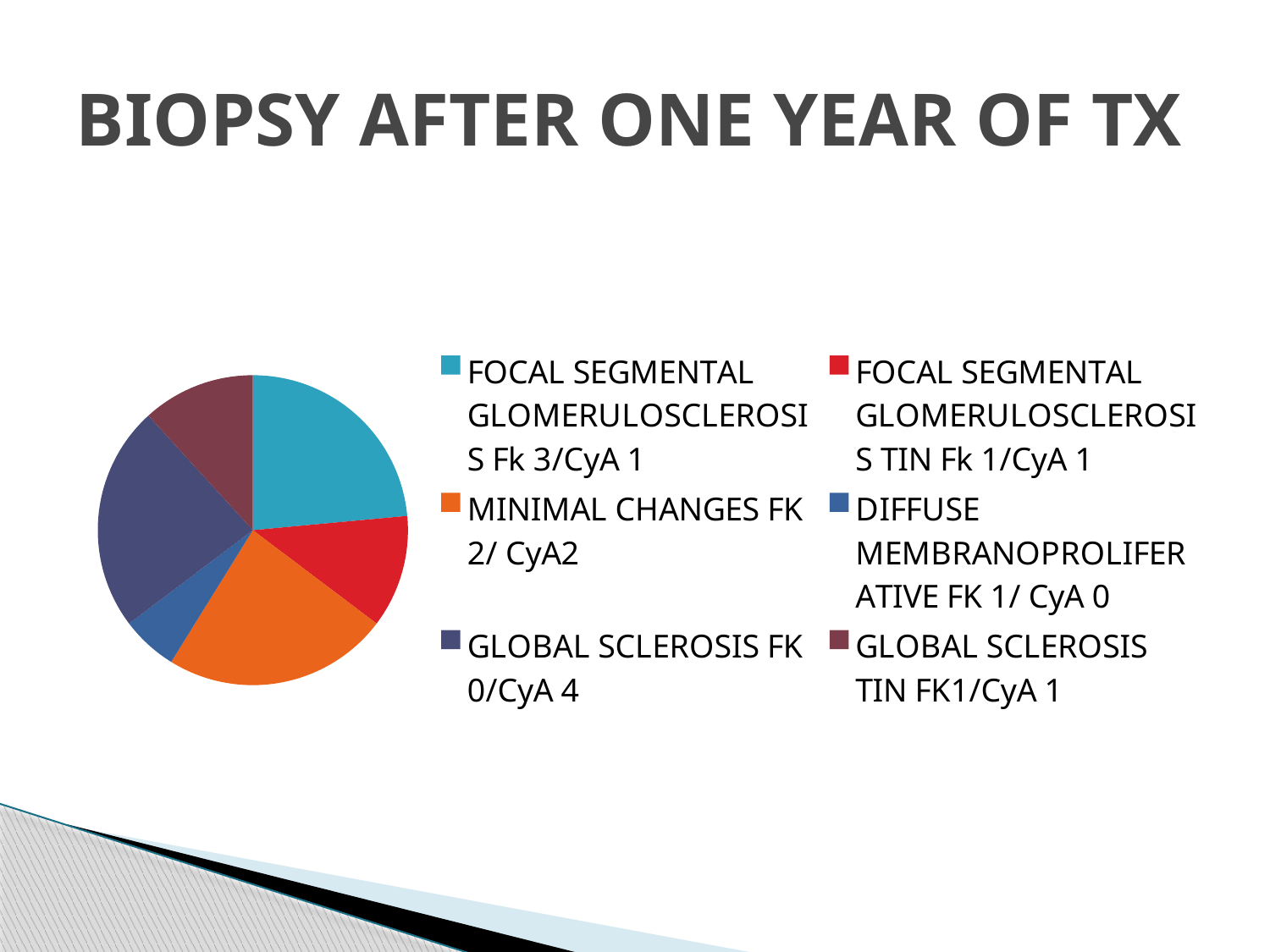
Which slice is larger: GLOBAL SCLEROSIS TIN FK1/CyA 1 or DIFFUSE MEMBRANOPROLIFERATIVE FK 1/ CyA 0? GLOBAL SCLEROSIS TIN FK1/CyA 1 Which slice is larger: MINIMAL CHANGES FK 2/ CyA2 or FOCAL SEGMENTAL GLOMERULOSCLEROSIS TIN Fk 1/CyA 1? MINIMAL CHANGES FK 2/ CyA2 What is the title of the slide containing the pie chart? BIOPSY AFTER ONE YEAR OF TX How many entries does the legend of the pie chart list? 6 Which slice is larger: GLOBAL SCLEROSIS FK 0/CyA 4 or GLOBAL SCLEROSIS TIN FK1/CyA 1? GLOBAL SCLEROSIS FK 0/CyA 4 What kind of chart is shown on the slide? pie chart How many slices does the pie chart have? 6 What colour is the slice for MINIMAL CHANGES FK 2/ CyA2 in the pie chart? orange Which category has the smallest slice in the pie chart? DIFFUSE MEMBRANOPROLIFERATIVE FK 1/ CyA 0